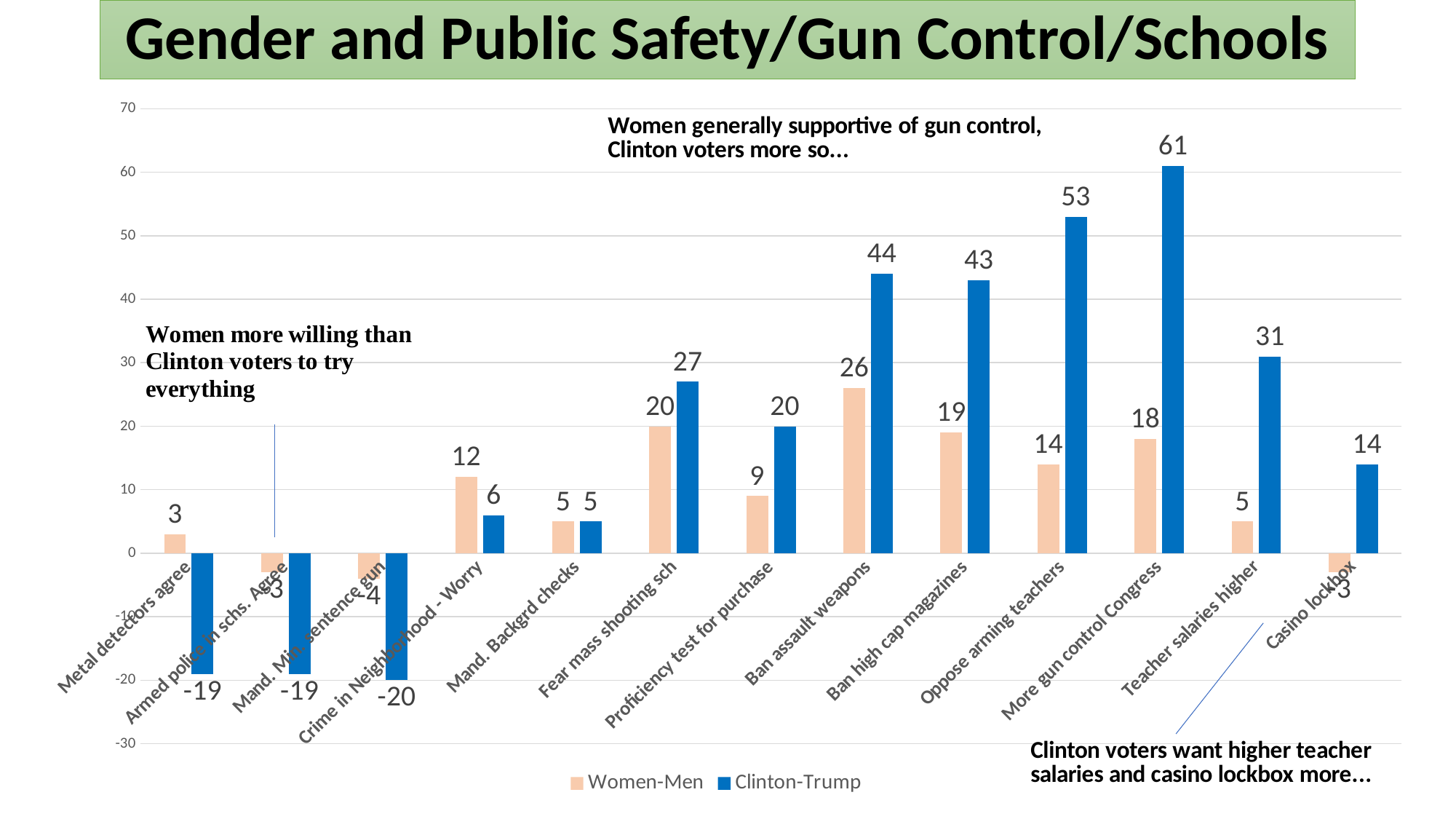
What is the Women-Men value for Crime in Neighborhood - Worry? 12 What are the two series named in the legend? Women-Men and Clinton-Trump How many series does the legend list? 2 What is the Clinton-Trump value for More gun control Congress? 61 Which category has the lowest Clinton-Trump value? Mand. Min. sentence gun What kind of chart is shown on the slide? Bar chart What is the Clinton-Trump value for Teacher salaries higher? 31 How many categories are shown on the x axis? 13 Which is larger for Fear mass shooting sch: the Women-Men value or the Clinton-Trump value? Clinton-Trump What is the Women-Men value for Ban assault weapons? 26 What is the difference between the Clinton-Trump and Women-Men values for Oppose arming teachers? 39 Which category has the highest Clinton-Trump value? More gun control Congress